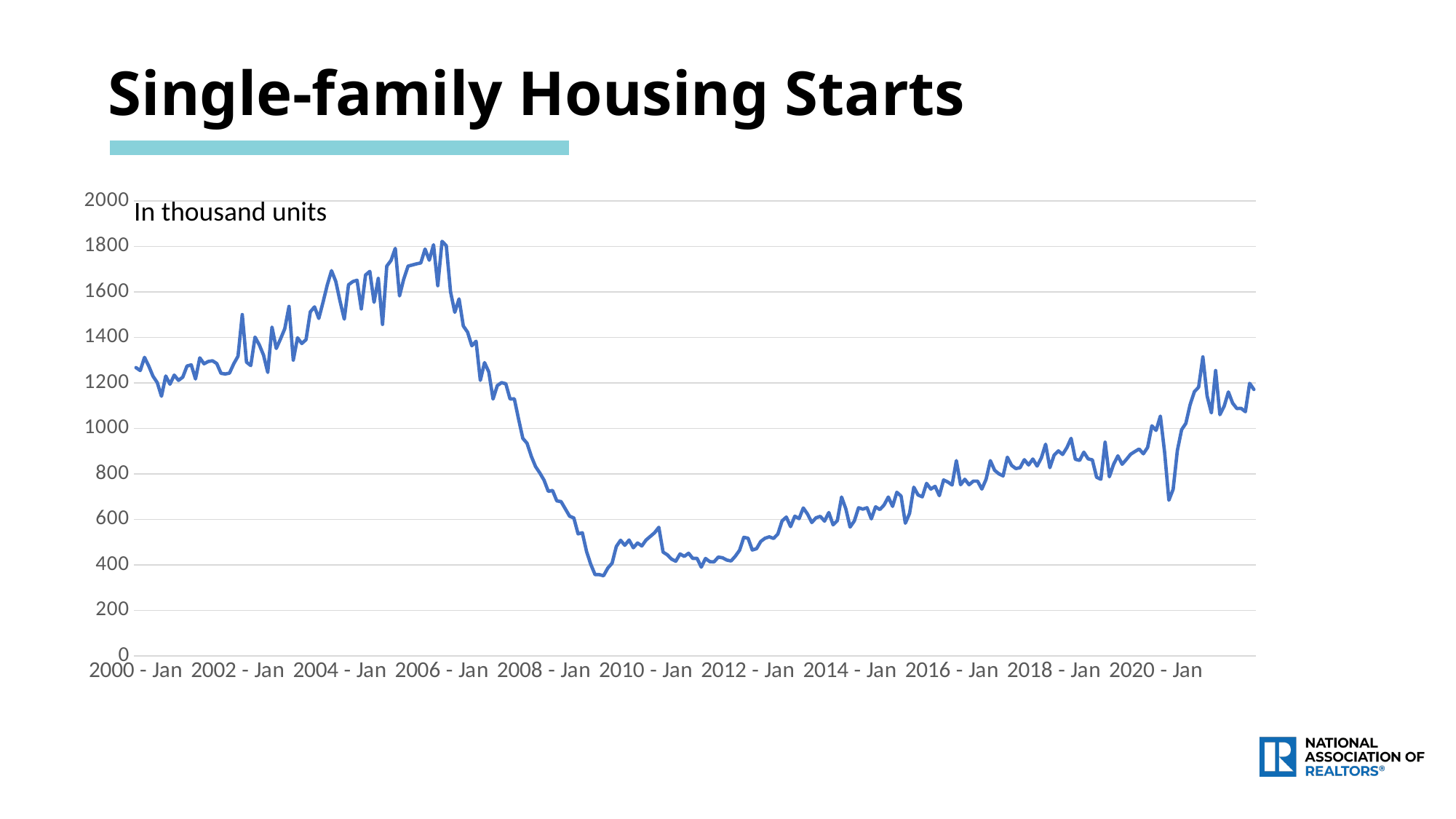
Is the value at 2016 - Jan greater or less than 1000? less What is the title of the chart? Single-family Housing Starts Does the line generally rise or fall between 2012 - Jan and 2020 - Jan? rise Does the line rise or fall between 2006 - Jan and 2010 - Jan? fall In what units are the values on the chart expressed? In thousand units Is the value at 2012 - Jan greater or less than 600? less What type of chart is shown on the slide? line chart Is the value at 2000 - Jan greater or less than 1000? greater Is the value at 2000 - Jan larger or smaller than the value at 2010 - Jan? larger